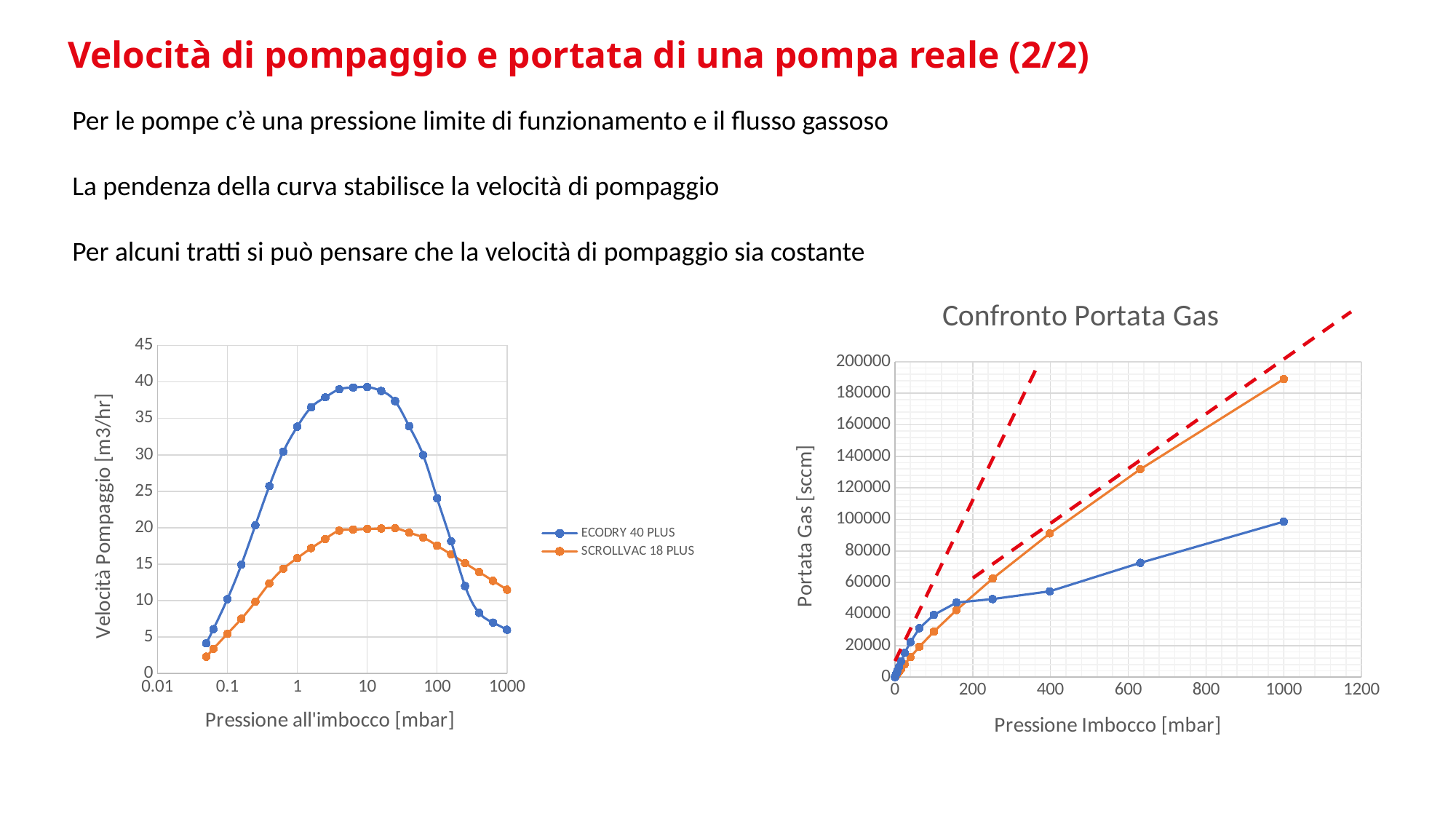
In the left chart, is the value for SCROLLVAC 18 PLUS at 10 mbar greater or less than 25? less In the left chart, is the value for ECODRY 40 PLUS at 10 mbar greater or less than 35? greater In the chart 'Confronto Portata Gas', which series has the higher value at 1000 mbar, the orange or the blue one? orange In the left chart, which series has the higher value at 10 mbar, ECODRY 40 PLUS or SCROLLVAC 18 PLUS? ECODRY 40 PLUS What is the title of the right chart? Confronto Portata Gas In the chart 'Confronto Portata Gas', is the value of the orange series at 1000 mbar greater or less than 160000? greater In the chart 'Confronto Portata Gas', do the values of the blue series rise or fall as pressure increases along the x axis? rise What kind of chart is the left chart with the legend ECODRY 40 PLUS and SCROLLVAC 18 PLUS? line chart What is the y-axis label of the left chart? Velocità Pompaggio [m3/hr] In the left chart, which series has the higher value at 1000 mbar, ECODRY 40 PLUS or SCROLLVAC 18 PLUS? SCROLLVAC 18 PLUS How many series does the legend of the left chart list? 2